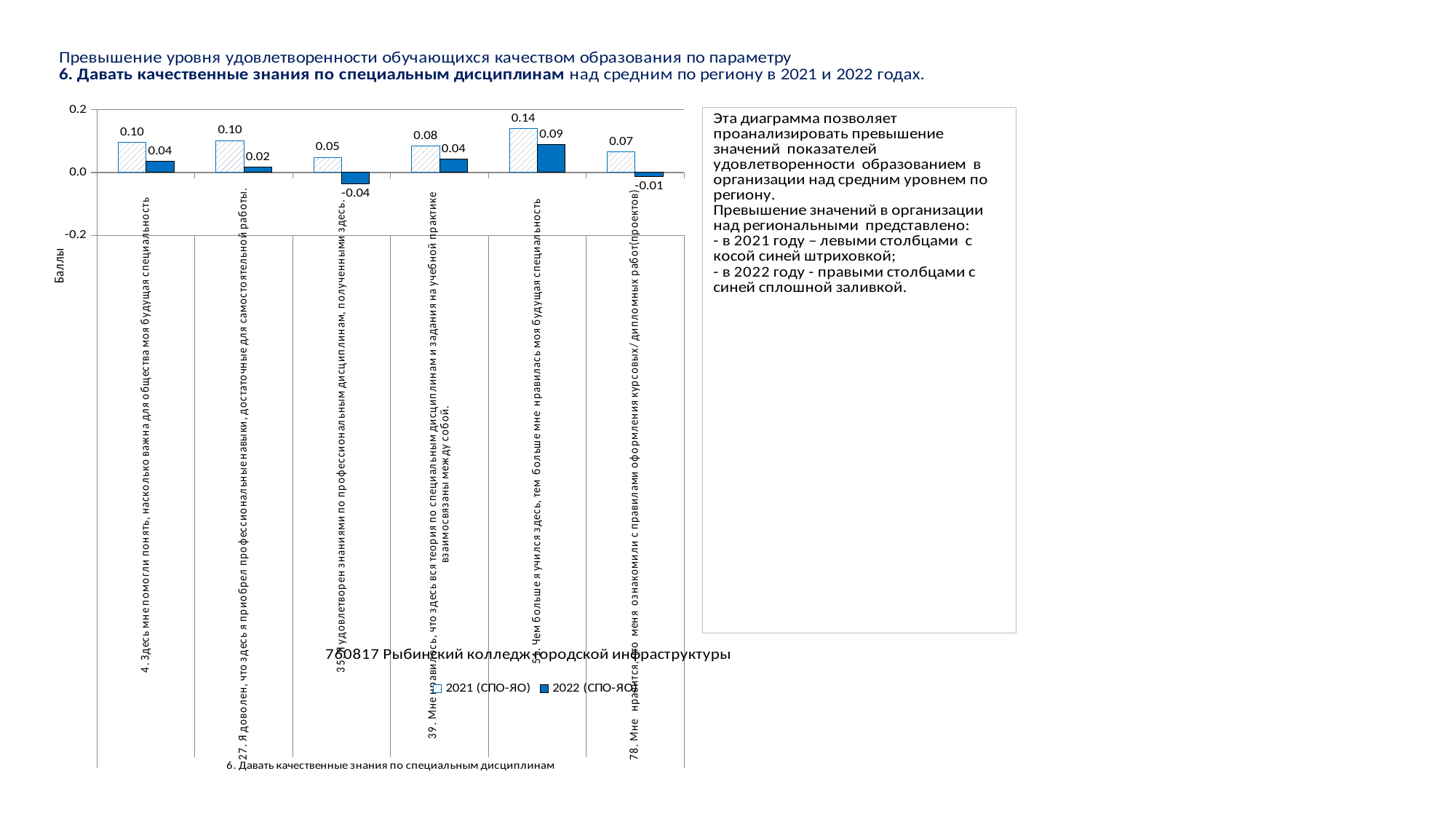
How many categories are shown on the chart? 6 What is the 2022 (СПО-ЯО) value for category 78 ("Мне нравится, что меня ознакомили с правилами оформления курсовых/дипломных работ")? -0.01 What is the 2021 (СПО-ЯО) value for category 4 ("Здесь мне помогли понять, насколько важна для общества моя будущая специальность")? 0.10 What is the 2022 (СПО-ЯО) value for category 35 ("Я удовлетворен знаниями по профессиональным дисциплинам, полученными здесь")? -0.04 What is the 2021 (СПО-ЯО) value for category 39 ("Мне нравится, что здесь вся теория по специальным дисциплинам и задания на учебной практике взаимосвязаны между собой")? 0.08 For the category "Чем больше я учился здесь, тем больше мне нравилась моя будущая специальность", which is larger: the 2021 value or the 2022 value? 2021 (0.14) Which category has the highest 2021 (СПО-ЯО) value? Чем больше я учился здесь, тем больше мне нравилась моя будущая специальность What kind of chart is shown on the slide? Bar chart What is the label of the vertical axis? Баллы How many series does the legend list? 2 Which category has the lowest 2022 (СПО-ЯО) value? 35. Я удовлетворен знаниями по профессиональным дисциплинам, полученными здесь What is the difference between the 2021 and 2022 values for category 27 ("Я доволен, что здесь я приобрел профессиональные навыки, достаточные для самостоятельной работы")? 0.08